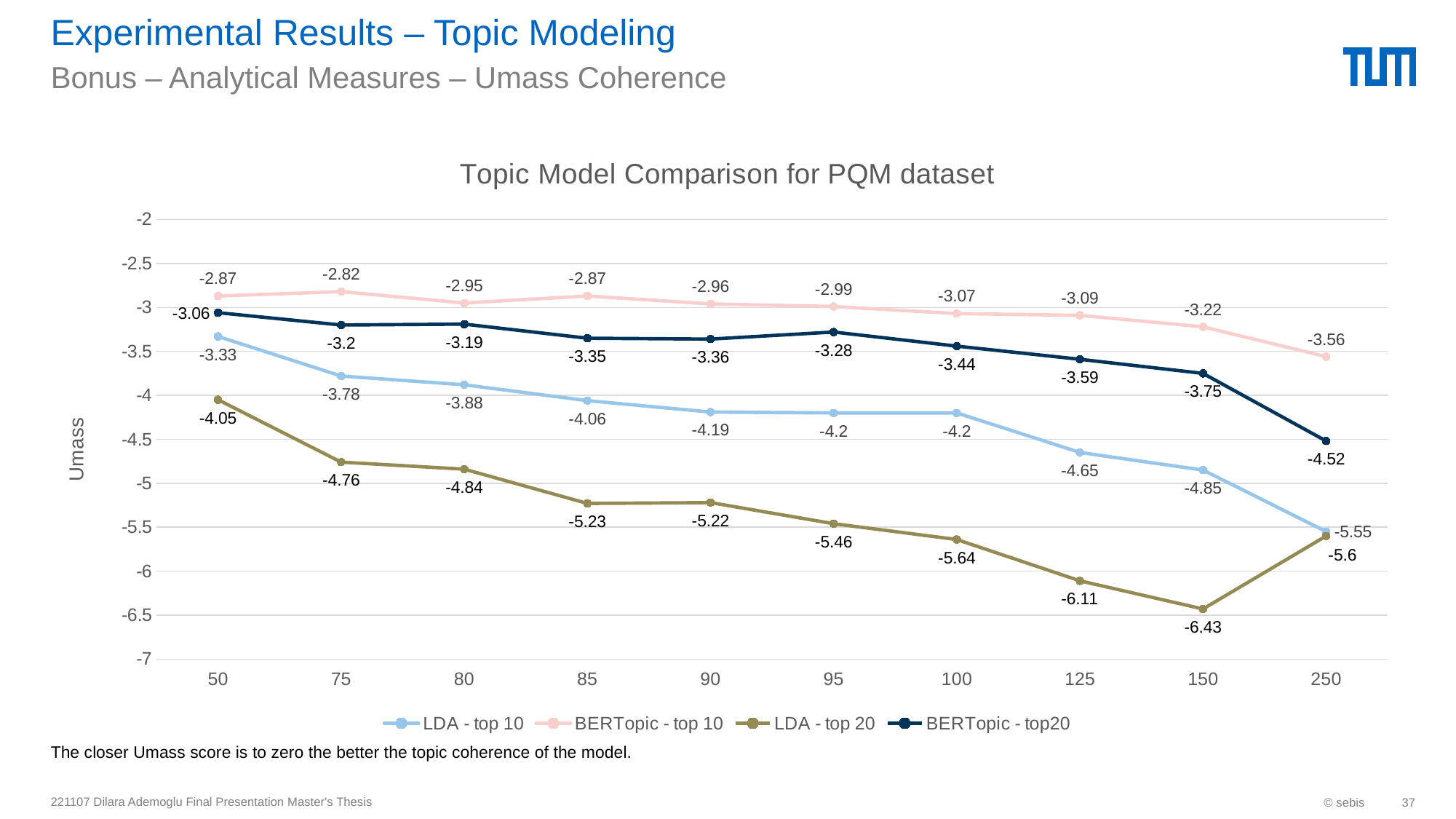
At which x-axis value does BERTopic - top 10 reach its highest Umass score? 75 What is the Umass value for LDA - top 20 at 150 topics? -6.43 At which x-axis value does LDA - top 20 reach its lowest Umass score? 150 How many x-axis points are plotted for each series? 10 What is the Umass value for LDA - top 10 at 100? -4.2 What is the difference between the BERTopic - top 10 value and the BERTopic - top20 value at 250? 0.96 Does the BERTopic - top20 series generally rise or fall from 50 to 250? Fall What is the Umass value for BERTopic - top20 at 50? -3.06 What is the Umass value for BERTopic - top 10 at 250? -3.56 At 250, which series has the higher Umass value: LDA - top 10 or LDA - top 20? LDA - top 10 How many series does the legend list? 4 What kind of chart is shown on the slide? Line chart